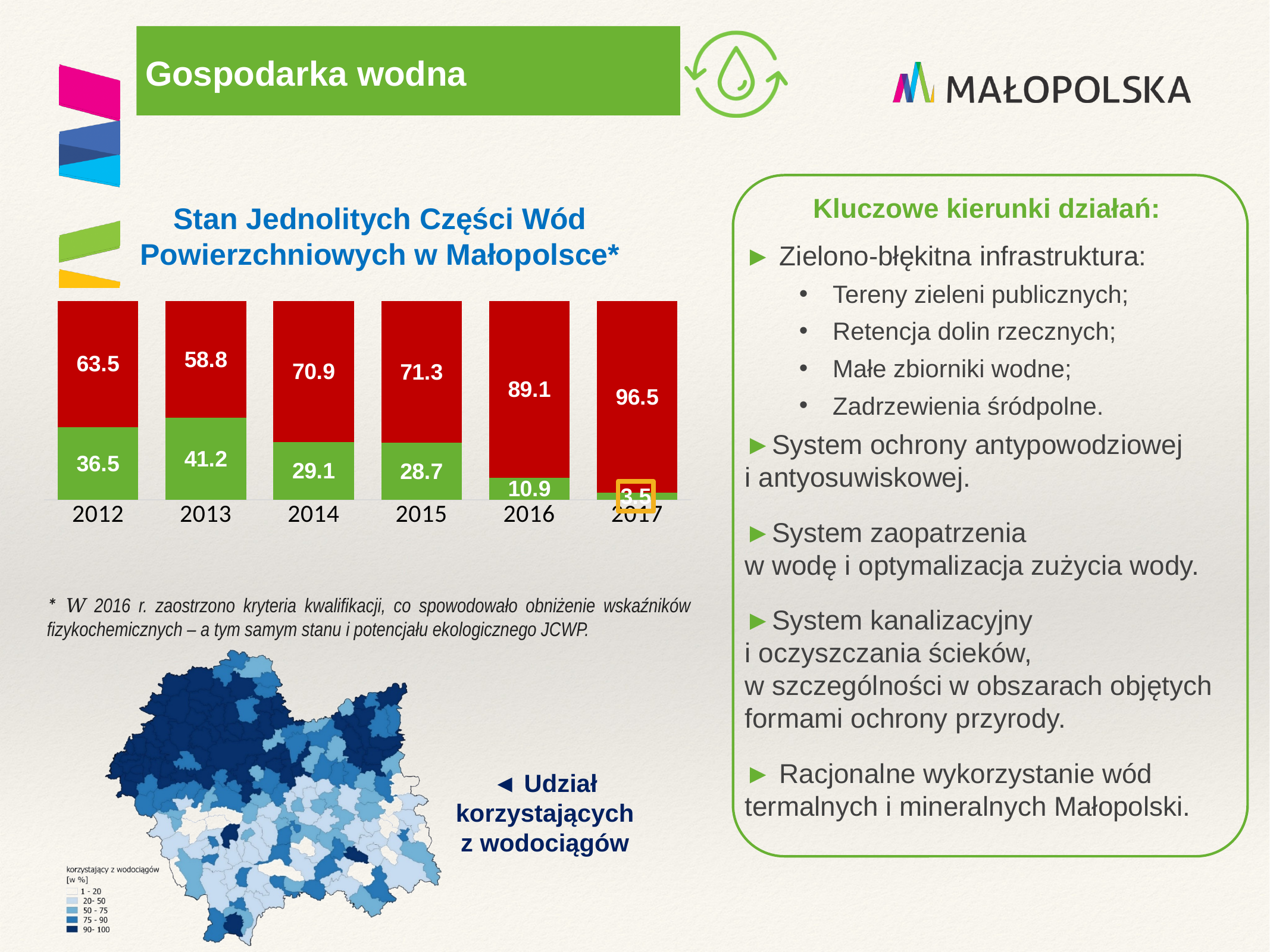
What is the value of the red segment for 2014 in the stacked bar chart? 70.9 What is the value of the red segment for 2016 in the stacked bar chart? 89.1 What is the value of the green segment for 2012 in the chart 'Stan Jednolitych Części Wód Powierzchniowych w Małopolsce'? 36.5 Which year has a larger green segment in the stacked bar chart, 2014 or 2015? 2014 In which year is the green segment the smallest in the stacked bar chart? 2017 Does the red segment generally rise or fall from 2013 to 2017 in the stacked bar chart? rise What is the value of the green segment for 2017 in the stacked bar chart? 3.5 What kind of chart is 'Stan Jednolitych Części Wód Powierzchniowych w Małopolsce'? stacked bar chart How many years are shown on the x axis of the stacked bar chart? 6 What is the difference between the red segment values for 2017 and 2012 in the stacked bar chart? 33.0 What is the total of the stacked bar for 2015 in the stacked bar chart? 100.0 In which year is the green segment the largest in the stacked bar chart? 2013